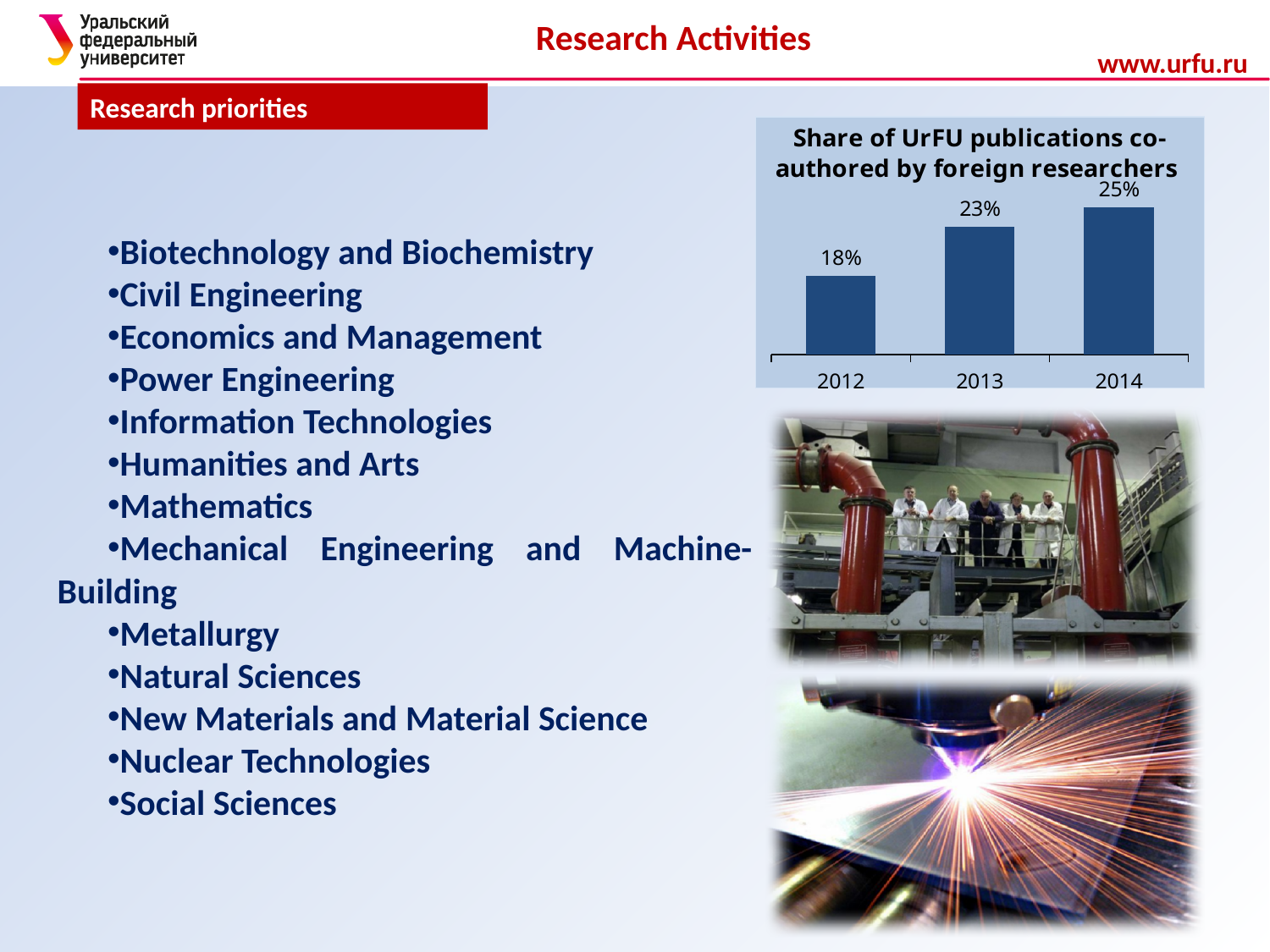
Which year has the lowest share of UrFU publications co-authored by foreign researchers? 2012 How many years are shown in the chart? 3 What is the title of the chart on the slide? Share of UrFU publications co-authored by foreign researchers What is the share of UrFU publications co-authored by foreign researchers in 2013? 23% What type of chart is used to show the share of UrFU publications co-authored by foreign researchers? Bar chart What is the share of UrFU publications co-authored by foreign researchers in 2014? 25% Which year has the highest share of UrFU publications co-authored by foreign researchers? 2014 By how many percentage points did the share of publications co-authored by foreign researchers increase from 2012 to 2014? 7 percentage points What is the share of UrFU publications co-authored by foreign researchers in 2012? 18% What is the difference between the 2013 and 2012 shares of publications co-authored by foreign researchers? 5 percentage points Does the share of UrFU publications co-authored by foreign researchers rise or fall from 2012 to 2014? Rise Which year has a larger share of publications co-authored by foreign researchers, 2012 or 2013? 2013